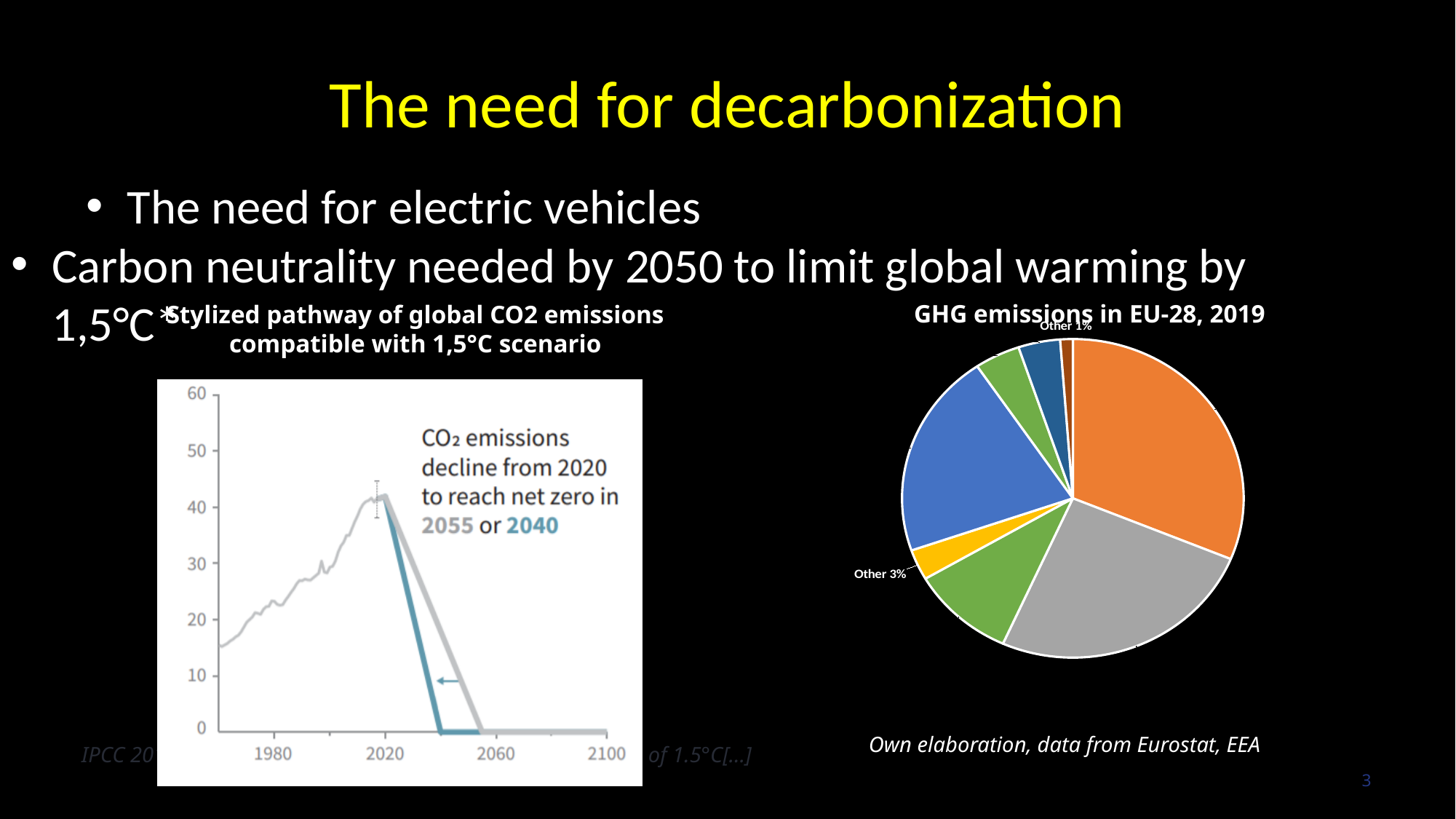
In the 'GHG emissions in EU-28, 2019' pie chart, which colour is the largest slice? orange In the 'Stylized pathway of global CO2 emissions' chart, do emissions rise or fall between 1980 and 2020? rise In the 'Stylized pathway of global CO2 emissions' chart, is the value in 2060 greater or less than 10? less In the 'Stylized pathway of global CO2 emissions' chart, is the value in 1980 greater or less than 10? greater In the 'Stylized pathway of global CO2 emissions' chart, what is the value of both pathways in 2100? 0 In the 'GHG emissions in EU-28, 2019' pie chart, what share is shown by the label near the small brown slice at the top? Other 1% What type of chart is the one titled 'Stylized pathway of global CO2 emissions compatible with 1,5°C scenario'? line chart What is the source note printed under the 'GHG emissions in EU-28, 2019' pie chart? Own elaboration, data from Eurostat, EEA What type of chart is the one titled 'GHG emissions in EU-28, 2019'? pie chart In the 'GHG emissions in EU-28, 2019' pie chart, what share is shown by the label near the yellow slice on the left? Other 3% In the 'Stylized pathway of global CO2 emissions' chart, according to the annotation, in which two years do the pathways reach net zero? 2055 or 2040 In the 'GHG emissions in EU-28, 2019' pie chart, which is larger: the slice labelled 'Other 3%' or the slice labelled 'Other 1%'? Other 3%